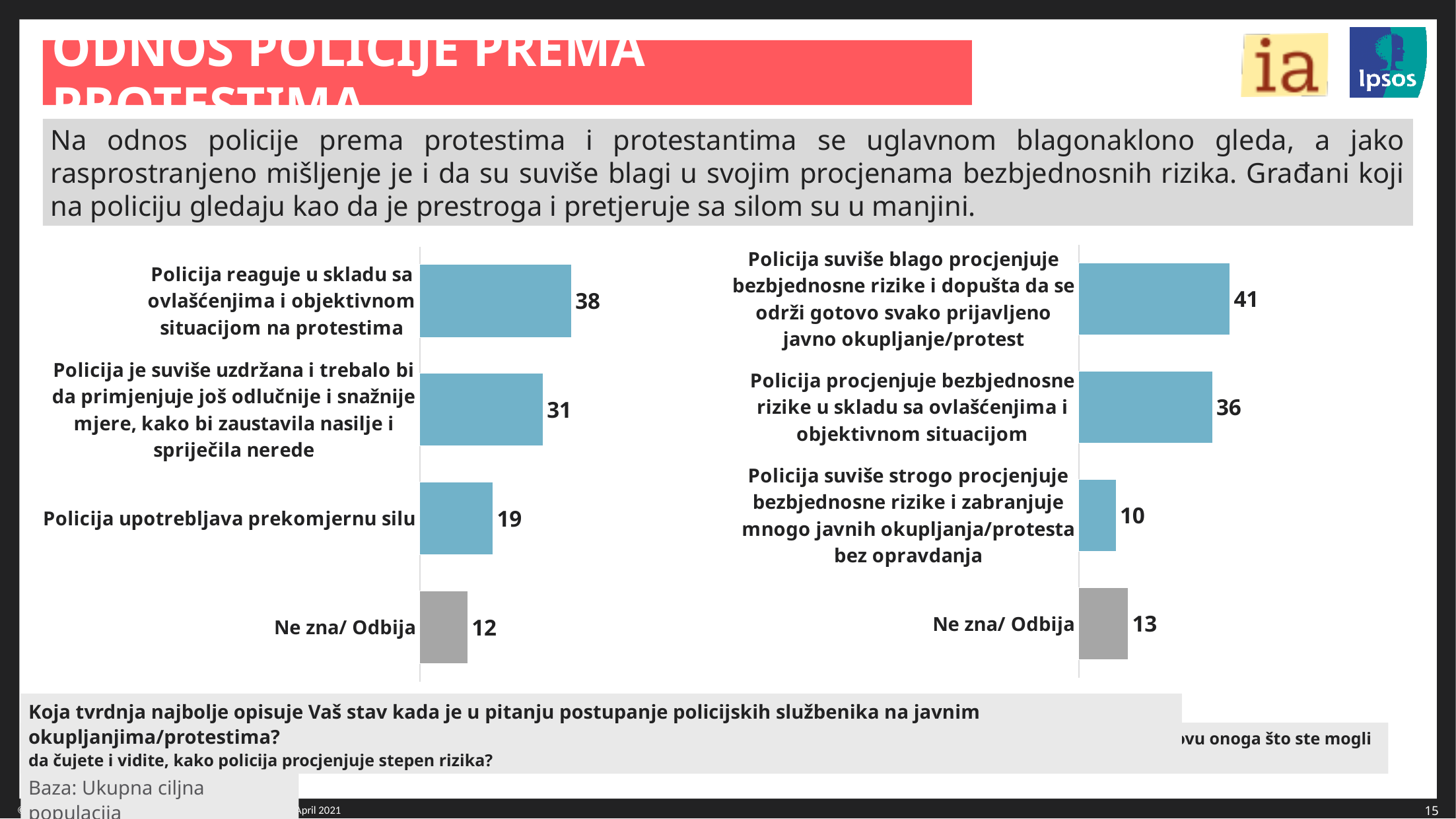
In the left chart, what colour is the bar for "Ne zna/ Odbija"? Grey In the right chart, which category has the highest value? Policija suviše blago procjenjuje bezbjednosne rizike i dopušta da se održi gotovo svako prijavljeno javno okupljanje/protest In the right chart, which category has the lowest value? Policija suviše strogo procjenjuje bezbjednosne rizike i zabranjuje mnogo javnih okupljanja/protesta bez opravdanja In the left chart, what is the difference between the values for "Policija reaguje u skladu sa ovlašćenjima i objektivnom situacijom na protestima" and "Policija je suviše uzdržana i trebalo bi da primjenjuje još odlučnije i snažnije mjere, kako bi zaustavila nasilje i spriječila nerede"? 7 What kind of chart is the right chart? Bar chart In the left chart, what is the value for "Policija reaguje u skladu sa ovlašćenjima i objektivnom situacijom na protestima"? 38 In the right chart, which is larger: the value for "Policija suviše strogo procjenjuje bezbjednosne rizike..." or the value for "Ne zna/ Odbija"? Ne zna/ Odbija In the right chart, what is the difference between the values for "Policija suviše blago procjenjuje bezbjednosne rizike..." and "Policija procjenjuje bezbjednosne rizike u skladu sa ovlašćenjima i objektivnom situacijom"? 5 In the right chart, what is the value for "Ne zna/ Odbija"? 13 How many categories does the left chart show? 4 In the left chart, which category has the lowest value? Ne zna/ Odbija In the left chart, what is the value for "Policija upotrebljava prekomjernu silu"? 19